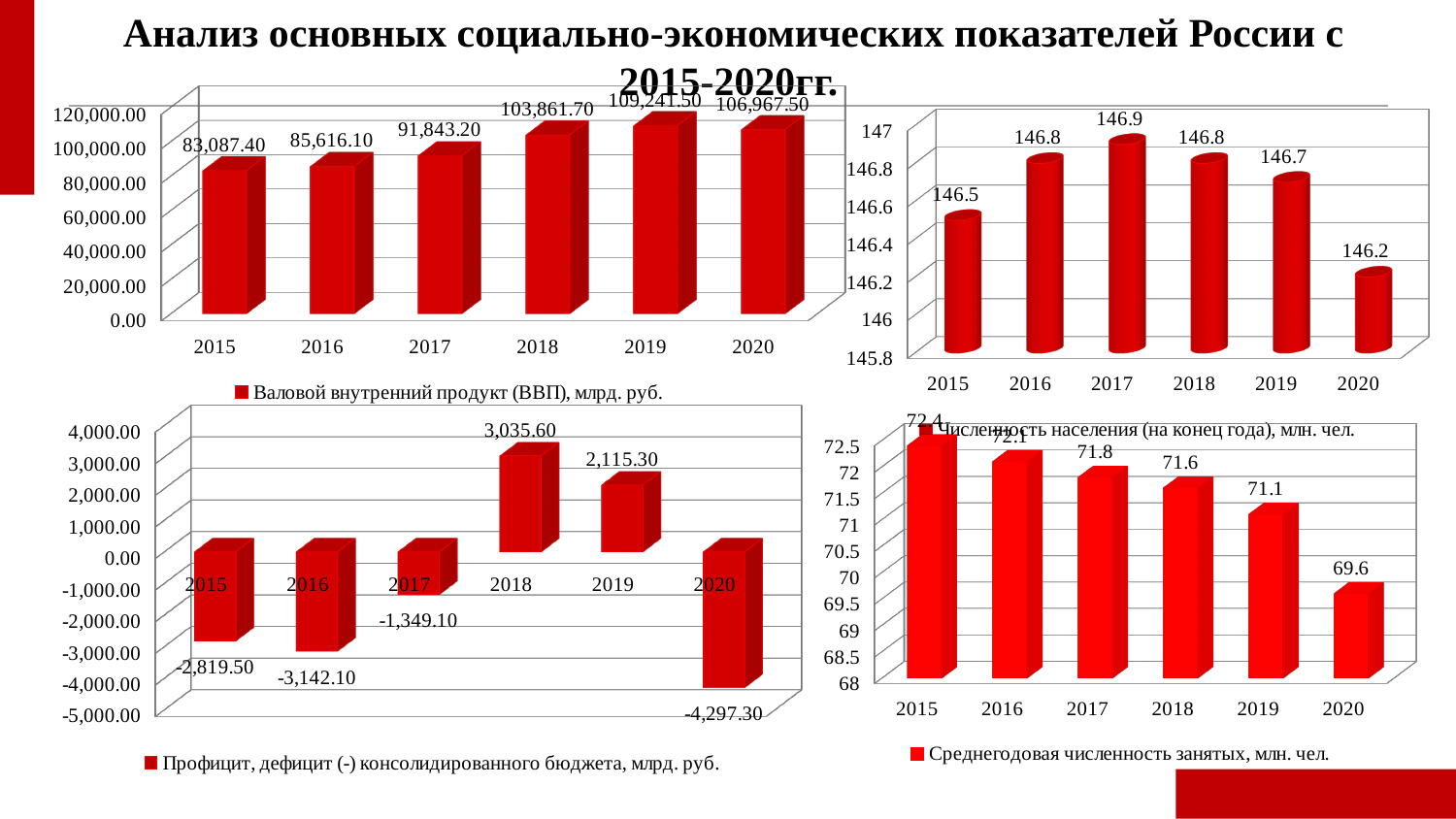
What kind of chart is the top-left chart showing GDP (Валовой внутренний продукт (ВВП), млрд. руб.)? bar chart On the budget chart (Профицит, дефицит (-) консолидированного бюджета, млрд. руб.), how many years are shown? 6 On the employment chart (Среднегодовая численность занятых, млн. чел.), do the values rise or fall from 2015 to 2020? fall On the GDP chart (Валовой внутренний продукт (ВВП), млрд. руб.), what is the difference between the 2019 and 2020 values? 2,274.00 On the employment chart (Среднегодовая численность занятых, млн. чел.), which is larger, the value for 2016 or the value for 2018? 2016 On the employment chart (Среднегодовая численность занятых, млн. чел.), what is the value for 2019? 71.1 On the GDP chart (Валовой внутренний продукт (ВВП), млрд. руб.), what is the value for 2018? 103,861.70 On the budget chart (Профицит, дефицит (-) консолидированного бюджета, млрд. руб.), which year has the highest value? 2018 On the population chart (Численность населения (на конец года), млн. чел.), what is the value for 2017? 146.9 On the GDP chart (Валовой внутренний продукт (ВВП), млрд. руб.), which year has the highest value? 2019 On the budget chart (Профицит, дефицит (-) консолидированного бюджета, млрд. руб.), what is the value for 2020? -4,297.30 On the population chart (Численность населения (на конец года), млн. чел.), which year has the lowest value? 2020